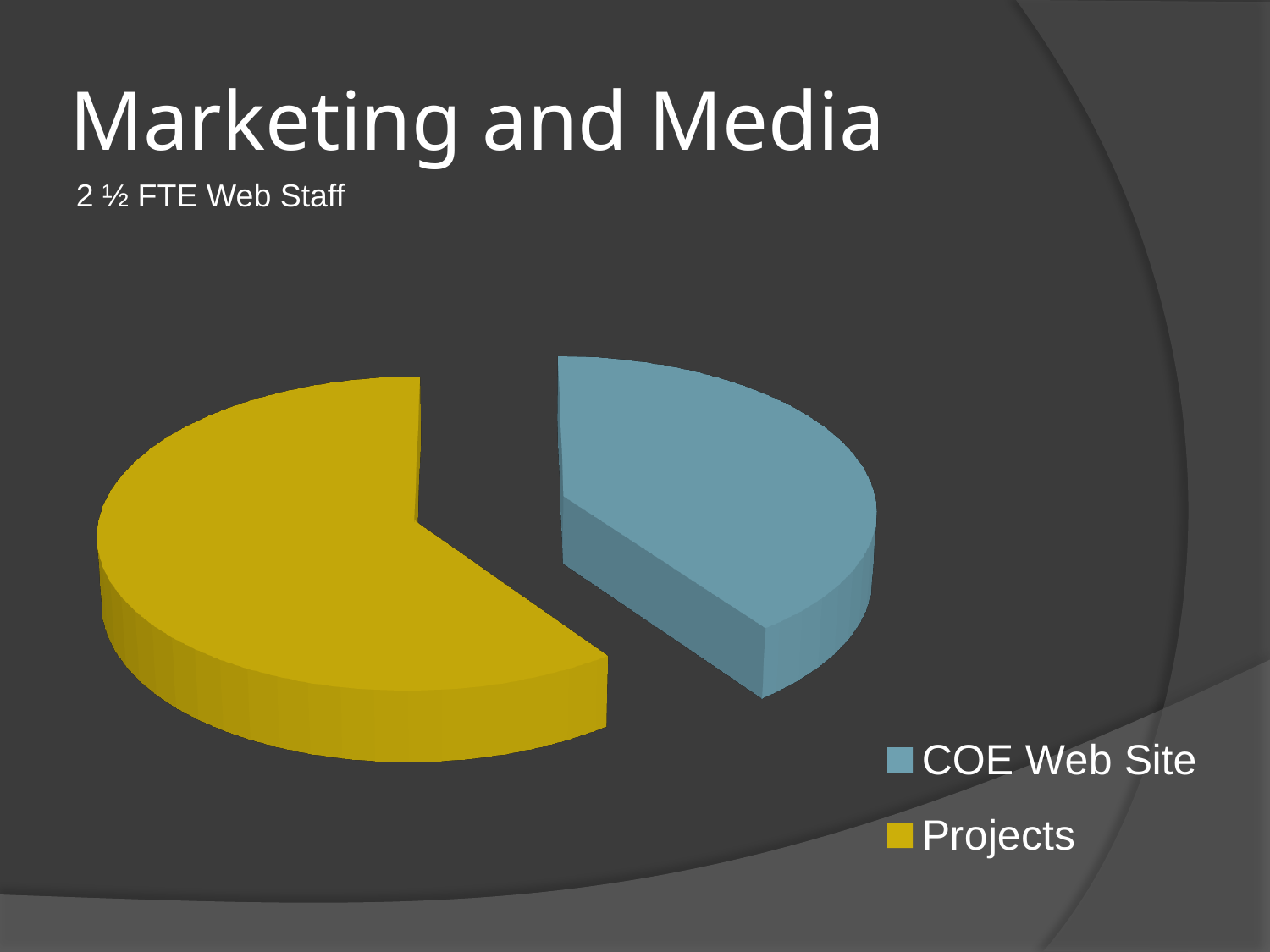
How many slices does the pie chart have? 2 What colour is the Projects slice? yellow What colour is the COE Web Site slice? blue What kind of chart is shown on the slide? pie chart Which slice is the smallest in the pie chart? COE Web Site Which slice is the largest in the pie chart? Projects How many entries does the legend list? 2 Which slice is larger, COE Web Site or Projects? Projects